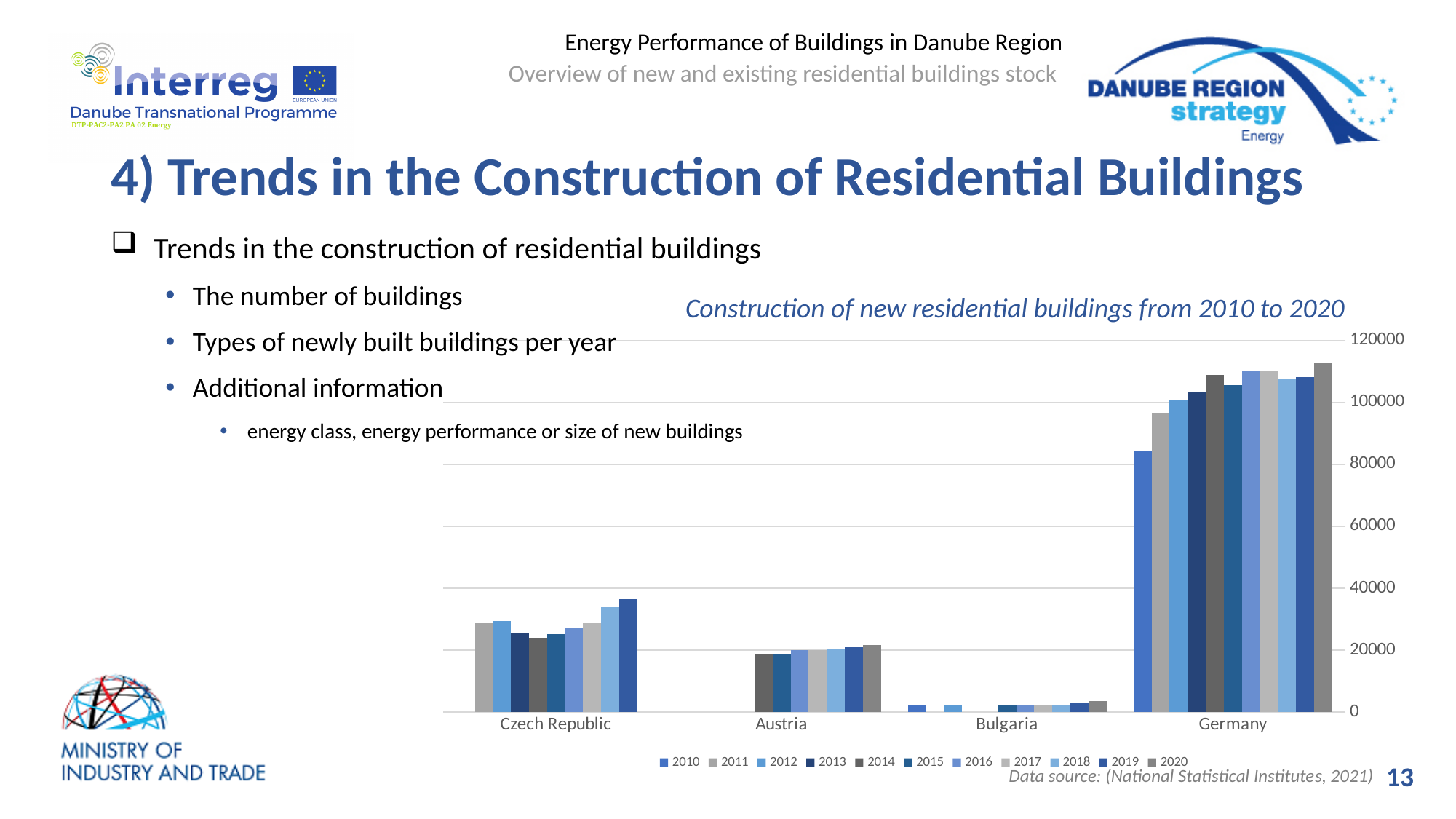
How many countries are shown on the x axis of the chart? 4 How many series (years) does the chart legend list? 11 Which country has the highest number of new residential buildings constructed? Germany Is the value for Germany in 2020 greater or less than 100000? greater Which country has the lowest number of new residential buildings constructed? Bulgaria What is the title of the chart? Construction of new residential buildings from 2010 to 2020 Is the value for Bulgaria in 2020 greater or less than 20000? less Do the values for Germany generally rise or fall from 2010 to 2020? rise What kind of chart is shown on the slide? Bar chart